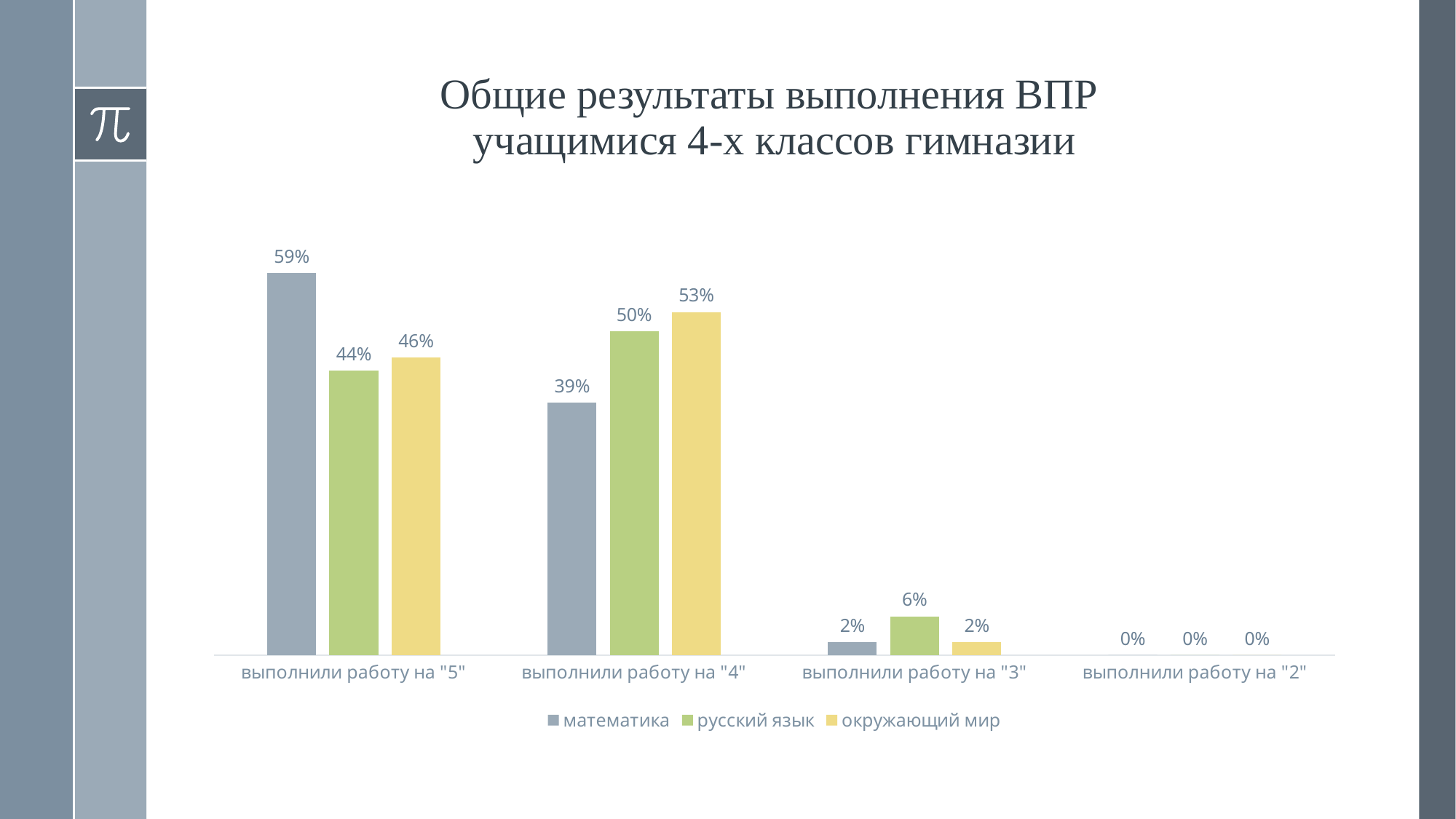
What is the value for окружающий мир in the category выполнили работу на "3"? 2% What is the value for all three subjects in the category выполнили работу на "2"? 0% What percentage of students got a "5" in математика? 59% Which colour represents окружающий мир in the chart? yellow Which is larger: окружающий мир for выполнили работу на "4" or окружающий мир for выполнили работу на "5"? выполнили работу на "4" What kind of chart is shown on the slide? bar chart Which subject has the highest value in the category выполнили работу на "5"? математика How many series does the legend list? 3 How many categories are shown on the x axis? 4 What is the value for русский язык in the category выполнили работу на "4"? 50% What is the difference between the математика and русский язык values in the category выполнили работу на "5"? 15% Which subject has the lowest value in the category выполнили работу на "4"? математика